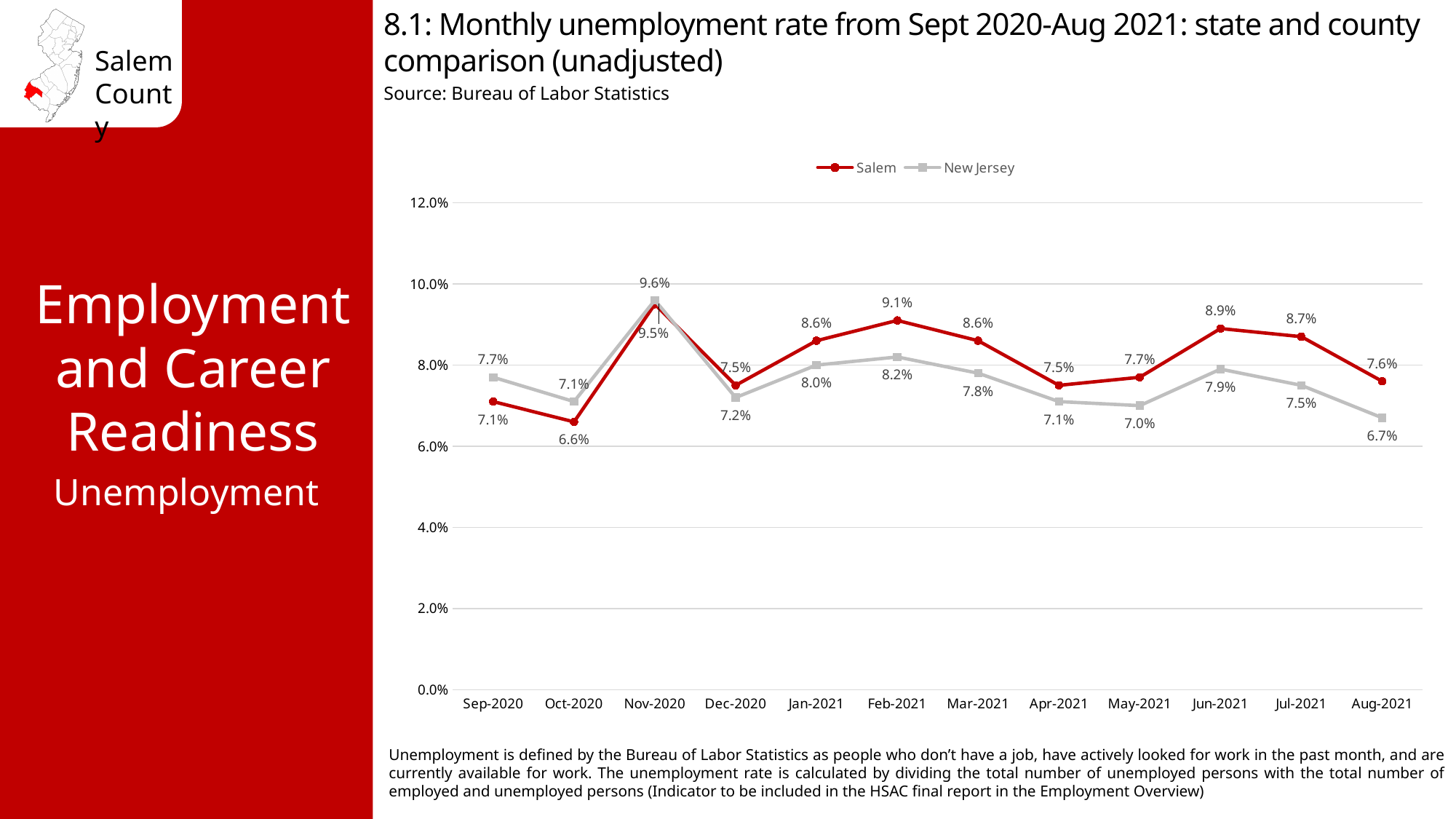
What was the Salem unemployment rate in Feb-2021? 9.1% Which series had the higher unemployment rate in Sep-2020, Salem or New Jersey? New Jersey How many months are plotted on the x axis? 12 Did the New Jersey unemployment rate rise or fall from Jun-2021 to Aug-2021? Fall What was the New Jersey unemployment rate in Nov-2020? 9.6% In which month did the Salem series reach its highest value? Nov-2020 Is the Salem value for Oct-2020 greater or less than 8.0%? less What is the difference between the Salem and New Jersey unemployment rates in Jun-2021? 1.0% What kind of chart is shown on the slide? Line chart How many series does the legend list? 2 In which month was the New Jersey unemployment rate lowest? Aug-2021 What was the Salem unemployment rate in Aug-2021? 7.6%